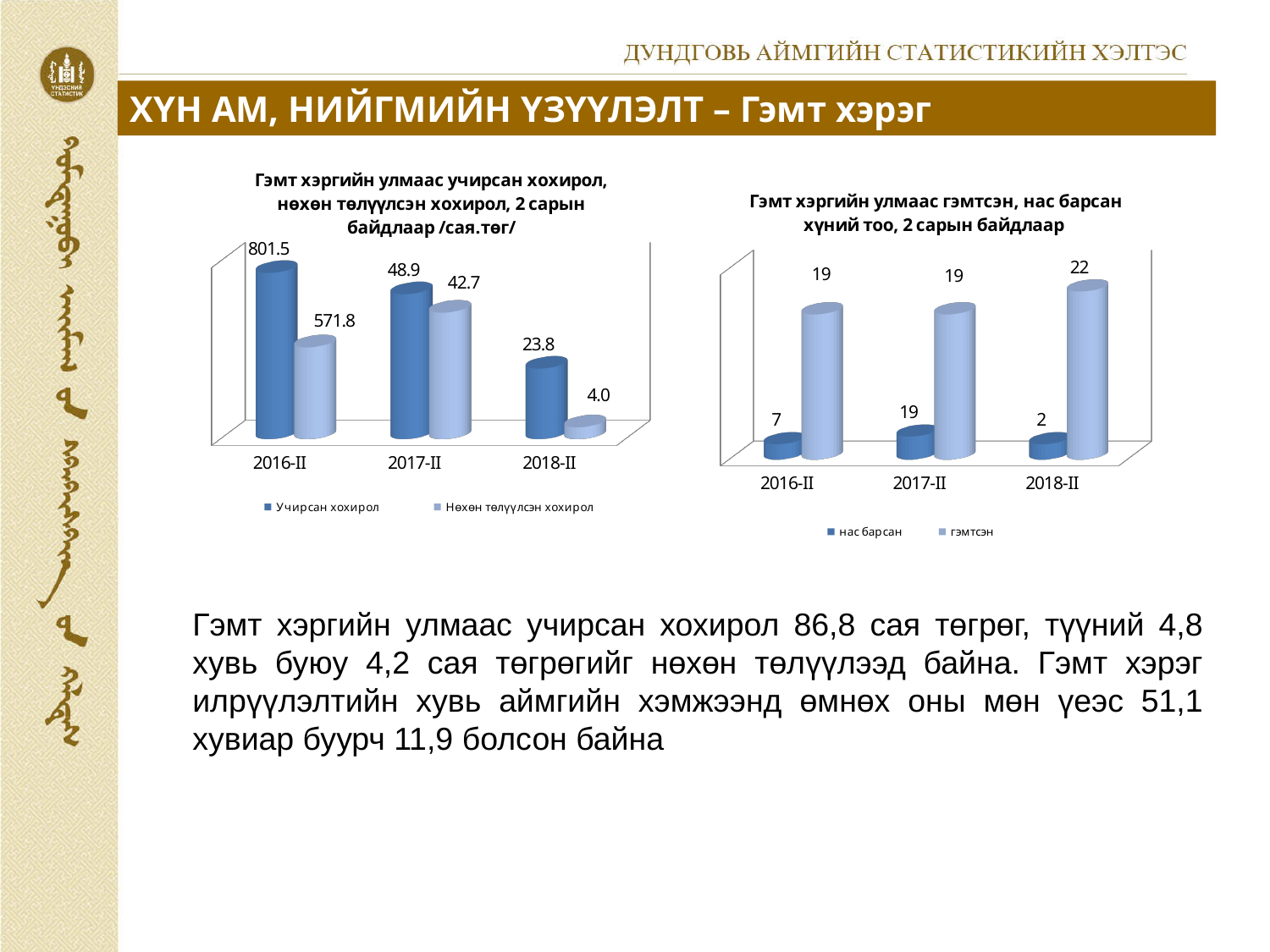
What type of chart is the right chart (Гэмт хэргийн улмаас гэмтсэн, нас барсан хүний тоо)? bar chart In the right chart (Гэмт хэргийн улмаас гэмтсэн, нас барсан хүний тоо), how many periods are shown on the x axis? 3 In the left chart (Гэмт хэргийн улмаас учирсан хохирол, нөхөн төлүүлсэн хохирол), what is the difference between Учирсан хохирол and Нөхөн төлүүлсэн хохирол in 2017-II? 6.2 In the right chart (Гэмт хэргийн улмаас гэмтсэн, нас барсан хүний тоо), which is larger in 2018-II: нас барсан or гэмтсэн? гэмтсэн In the right chart (Гэмт хэргийн улмаас гэмтсэн, нас барсан хүний тоо), which period has the lowest нас барсан value? 2018-II In the left chart (Гэмт хэргийн улмаас учирсан хохирол, нөхөн төлүүлсэн хохирол), what is the value of Нөхөн төлүүлсэн хохирол for 2018-II? 4.0 In the left chart (Гэмт хэргийн улмаас учирсан хохирол, нөхөн төлүүлсэн хохирол), which period has the highest Учирсан хохирол value? 2016-II In the right chart (Гэмт хэргийн улмаас гэмтсэн, нас барсан хүний тоо), what is the value of гэмтсэн for 2018-II? 22 In the left chart (Гэмт хэргийн улмаас учирсан хохирол, нөхөн төлүүлсэн хохирол), how many series does the legend list? 2 In the left chart (Гэмт хэргийн улмаас учирсан хохирол, нөхөн төлүүлсэн хохирол), does the Учирсан хохирол series rise or fall from 2016-II to 2018-II? fall In the left chart (Гэмт хэргийн улмаас учирсан хохирол, нөхөн төлүүлсэн хохирол), what is the value of Учирсан хохирол for 2016-II? 801.5 In the right chart (Гэмт хэргийн улмаас гэмтсэн, нас барсан хүний тоо), what is the value of нас барсан for 2016-II? 7